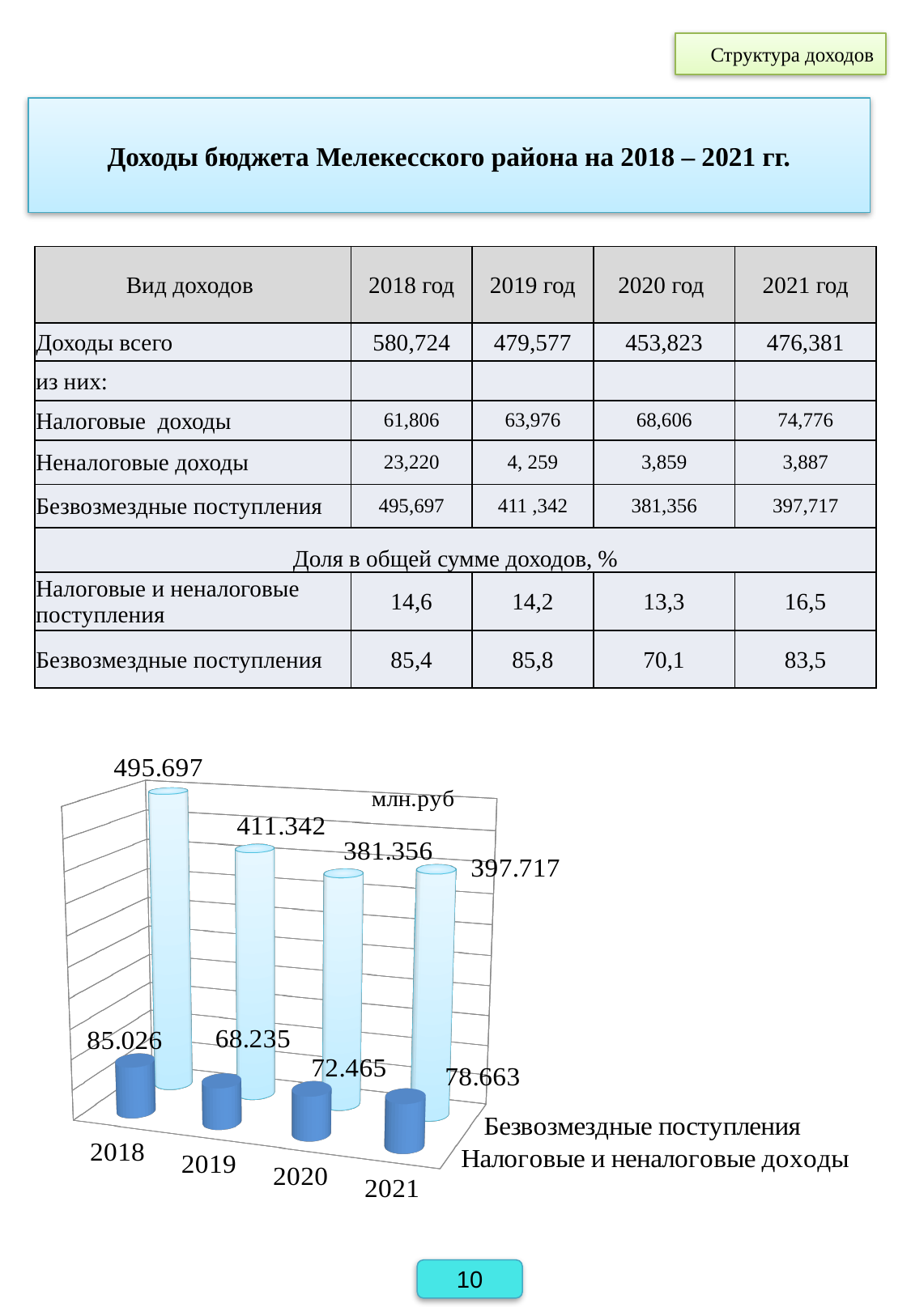
What is the value for Безвозмездные поступления in 2018 on the chart? 495.697 Which is larger on the chart: Безвозмездные поступления in 2020 or in 2021? 2021 In which year is Налоговые и неналоговые доходы lowest on the chart? 2019 What is the difference between Безвозмездные поступления in 2018 and 2019 on the chart? 84.355 What is the value for Безвозмездные поступления in 2021 on the chart? 397.717 What is the value for Налоговые и неналоговые доходы in 2020 on the chart? 72.465 Does Безвозмездные поступления rise or fall from 2018 to 2020 on the chart? fall How many data series does the chart show? 2 In which year is Безвозмездные поступления highest on the chart? 2018 What is the difference between Налоговые и неналоговые доходы in 2018 and 2019 on the chart? 16.791 How many years are shown on the x axis of the chart? 4 What kind of chart is shown on the slide? bar chart